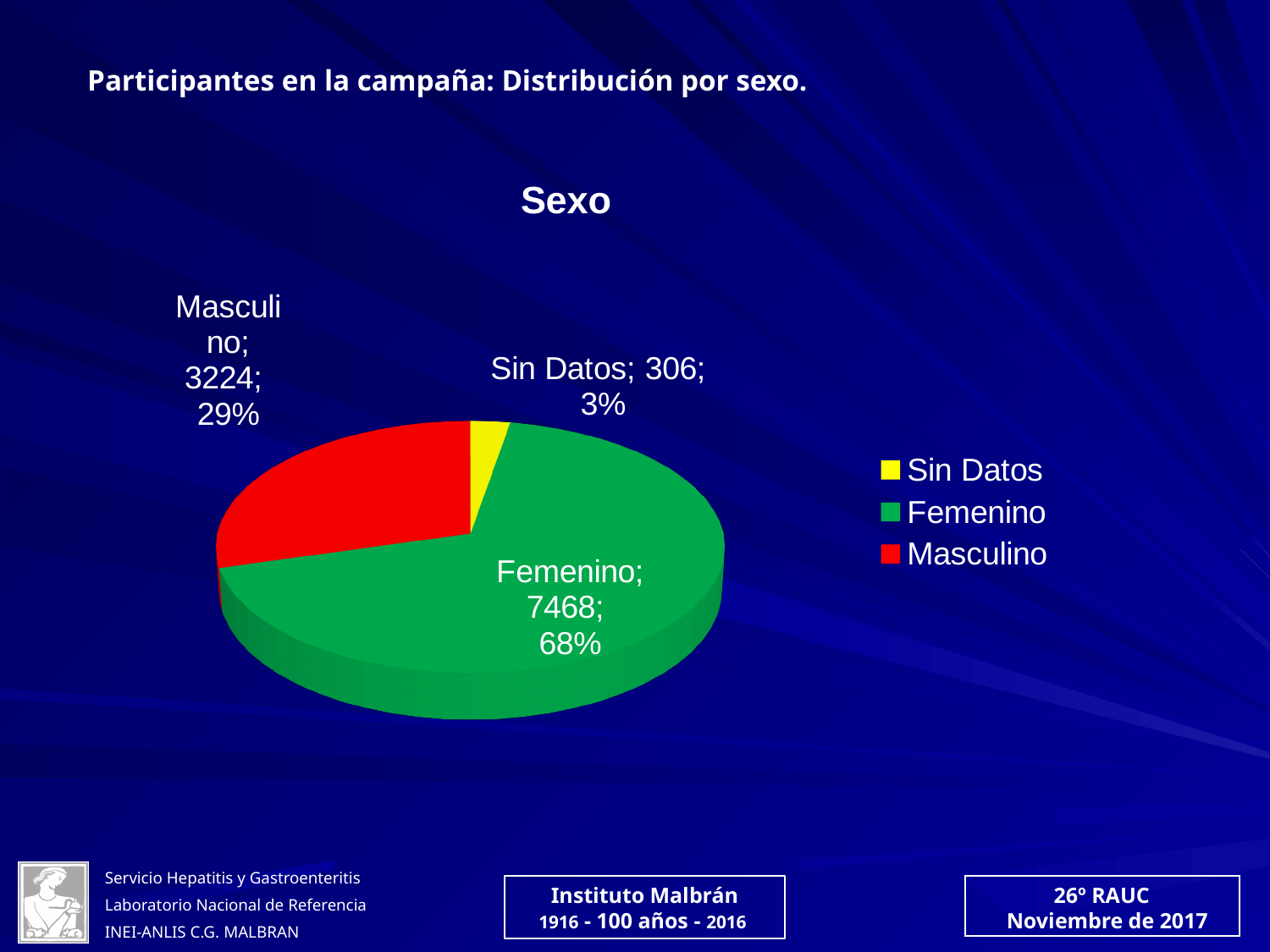
Which category has the smallest slice? Sin Datos What is the chart's title? Sexo What is the value for Femenino? 7468 What is the value for Sin Datos? 306 What share of the pie does Masculino represent? 29% What is the value for Masculino? 3224 What share of the pie does Femenino represent? 68% Which category has the largest slice? Femenino How many entries does the legend list? 3 What kind of chart is shown on the slide? pie chart How many slices does the pie chart have? 3 What is the difference between the Femenino and Masculino values? 4244